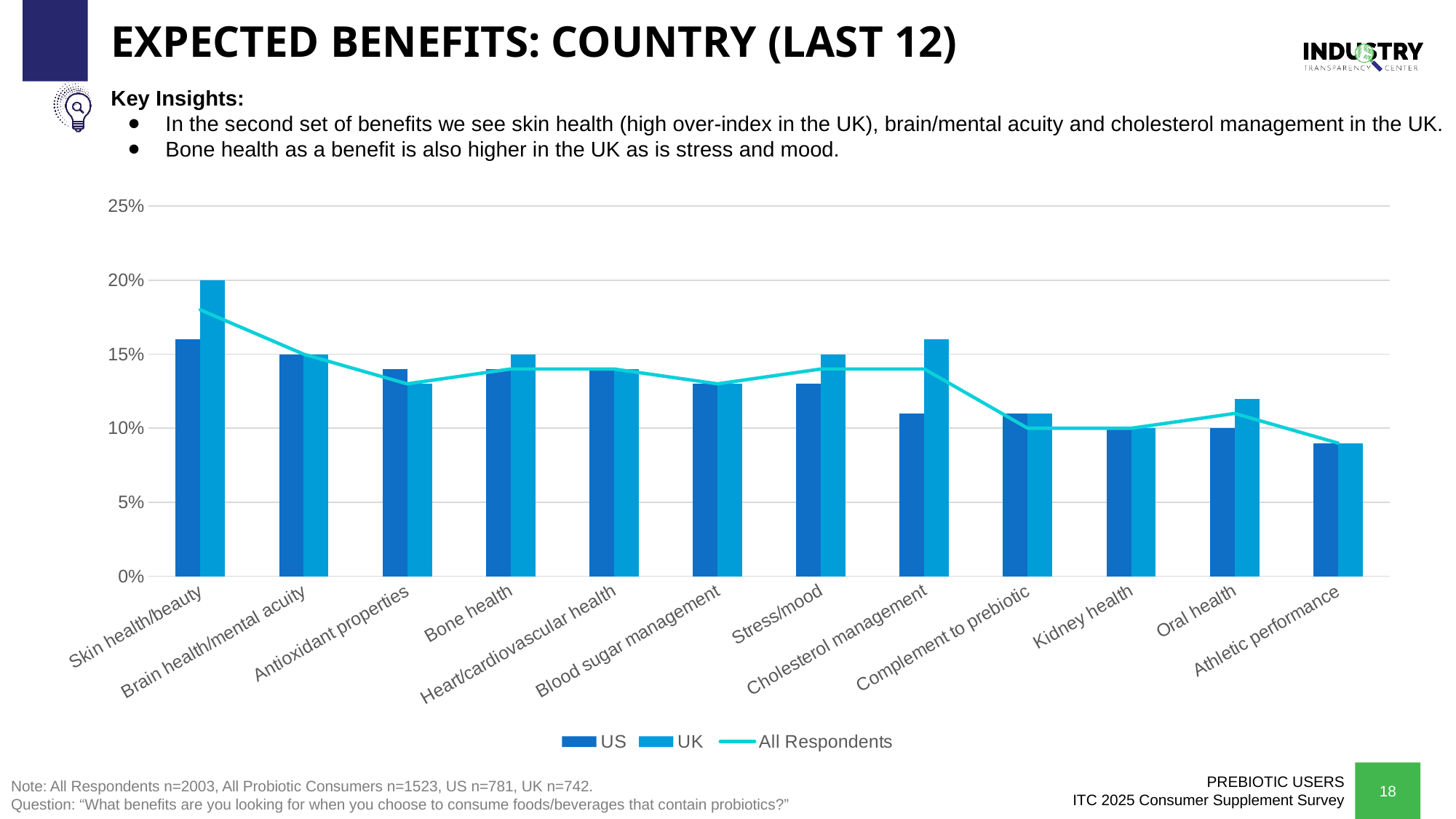
Does the All Respondents line generally rise or fall from left to right across the categories? Fall How many benefit categories are shown on the x axis? 12 For Cholesterol management, which is larger, the US value or the UK value? UK How many series does the legend list? 3 Which series is shown as a line rather than bars? All Respondents What is the UK value for Skin health/beauty? 20% Is the UK value for Athletic performance greater or less than 10%? less What is the US value for Kidney health? 10% Which category has the highest UK value? Skin health/beauty Is the US value for Skin health/beauty greater or less than 15%? greater Which category has the lowest US value? Athletic performance What kind of chart is shown on the slide? Bar chart with a line